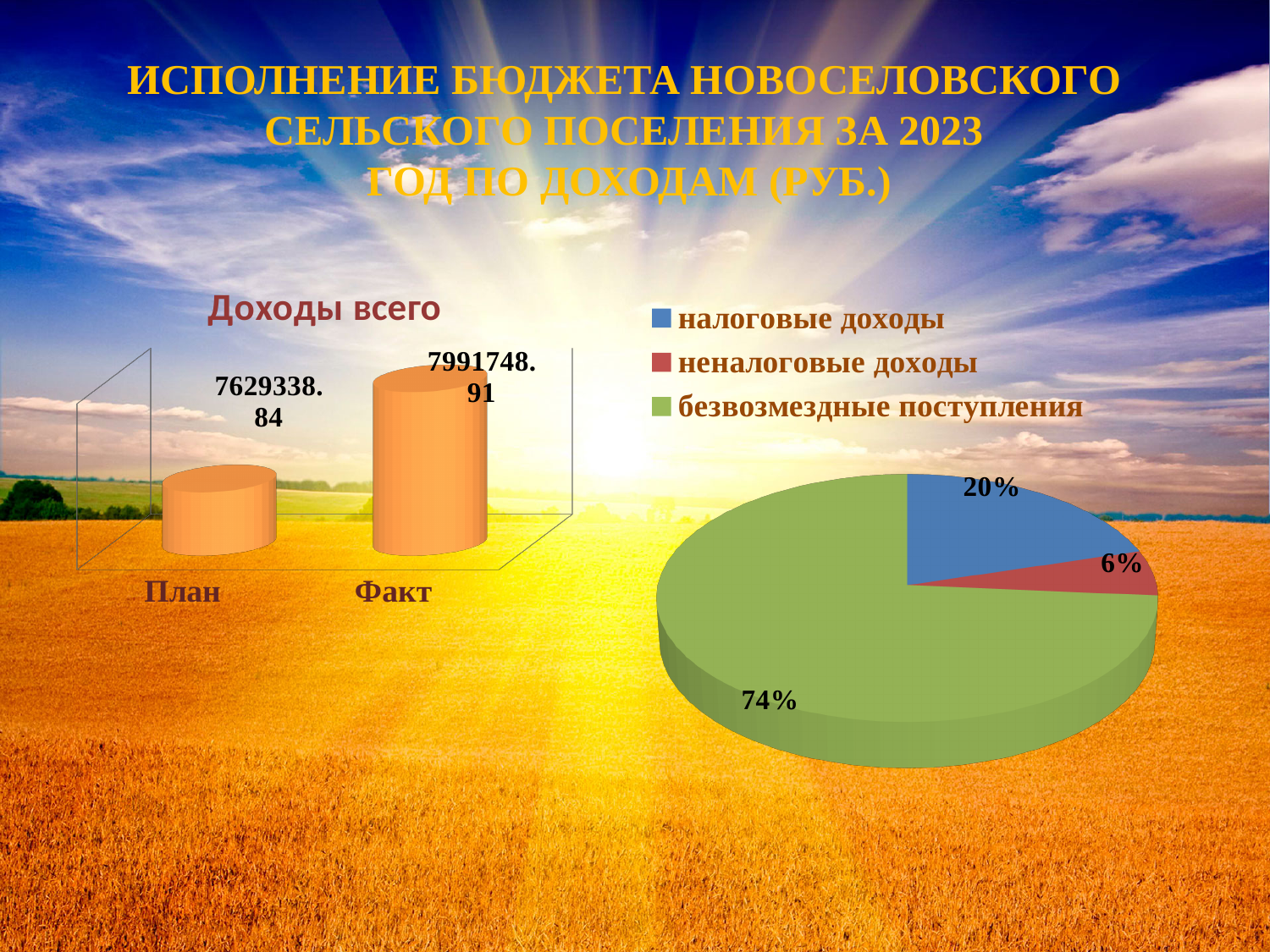
How many entries does the legend of the pie chart on the right list? 3 In the 'Доходы всего' chart, how many categories are shown? 2 In the pie chart on the right, what share is неналоговые доходы? 6% In the 'Доходы всего' chart, what is the difference between Факт and План? 362410.07 In the pie chart on the right, what share is налоговые доходы? 20% In the 'Доходы всего' chart, what is the value for Факт? 7991748.91 What kind of chart is the 'Доходы всего' chart on the left? Bar chart In the 'Доходы всего' chart, what is the value for План? 7629338.84 In the pie chart on the right, what share is безвозмездные поступления? 74% In the pie chart on the right, which category has the smallest share? неналоговые доходы In the pie chart on the right, which category has the largest share? безвозмездные поступления In the 'Доходы всего' chart, which category has the higher value, План or Факт? Факт